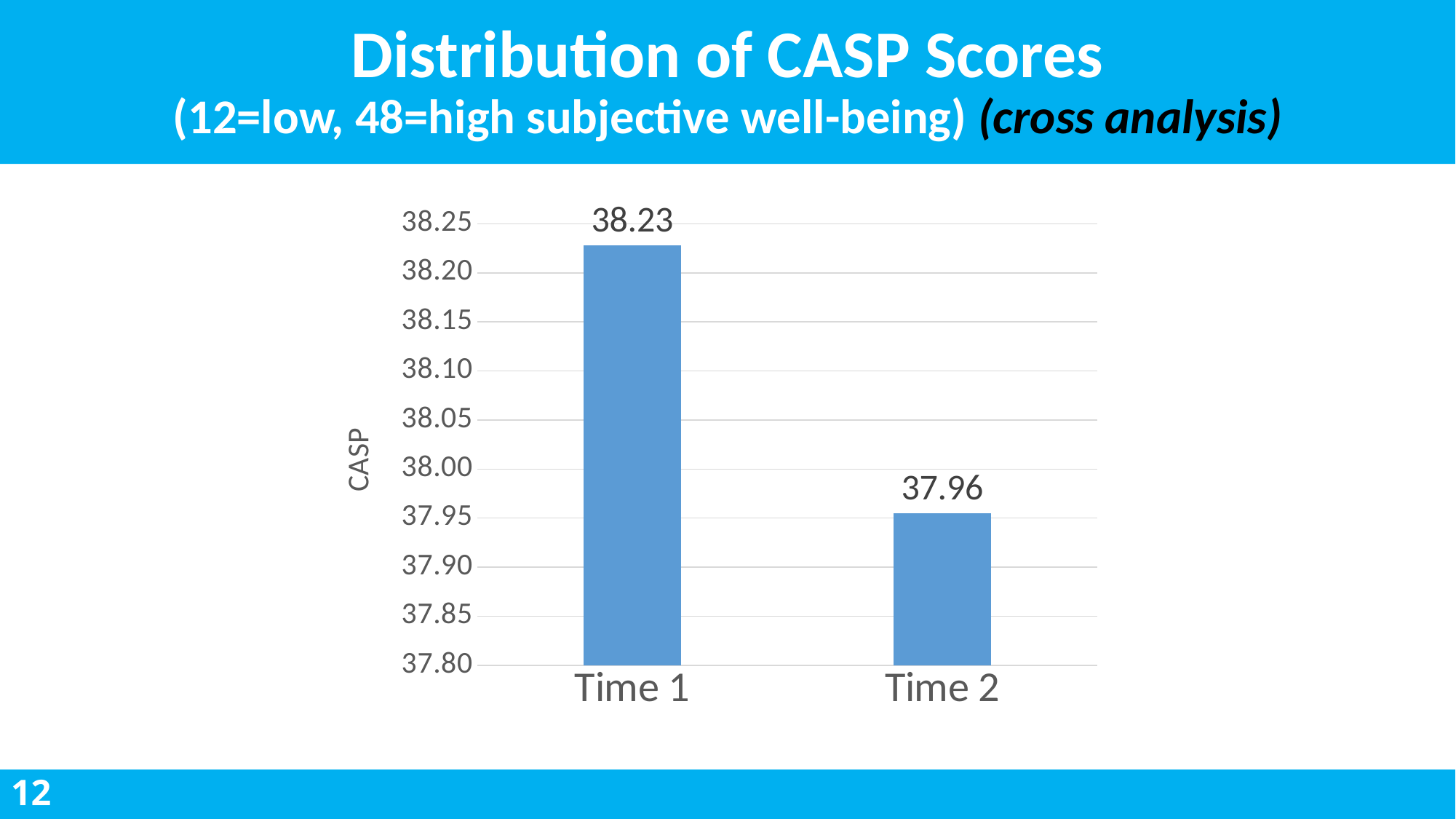
What is the label of the vertical axis? CASP Which time point has the lower CASP score? Time 2 Is the CASP score at Time 2 larger or smaller than at Time 1? smaller What is the CASP score at Time 2? 37.96 What is the difference between the CASP scores at Time 1 and Time 2? 0.27 Which time point has the higher CASP score? Time 1 What kind of chart is shown on the slide? bar chart Is the value for Time 2 greater or less than 38.00? less What is the CASP score at Time 1? 38.23 How many categories are shown on the x axis? 2 Is the value for Time 1 greater or less than 38.20? greater Do the CASP scores rise or fall from Time 1 to Time 2? fall